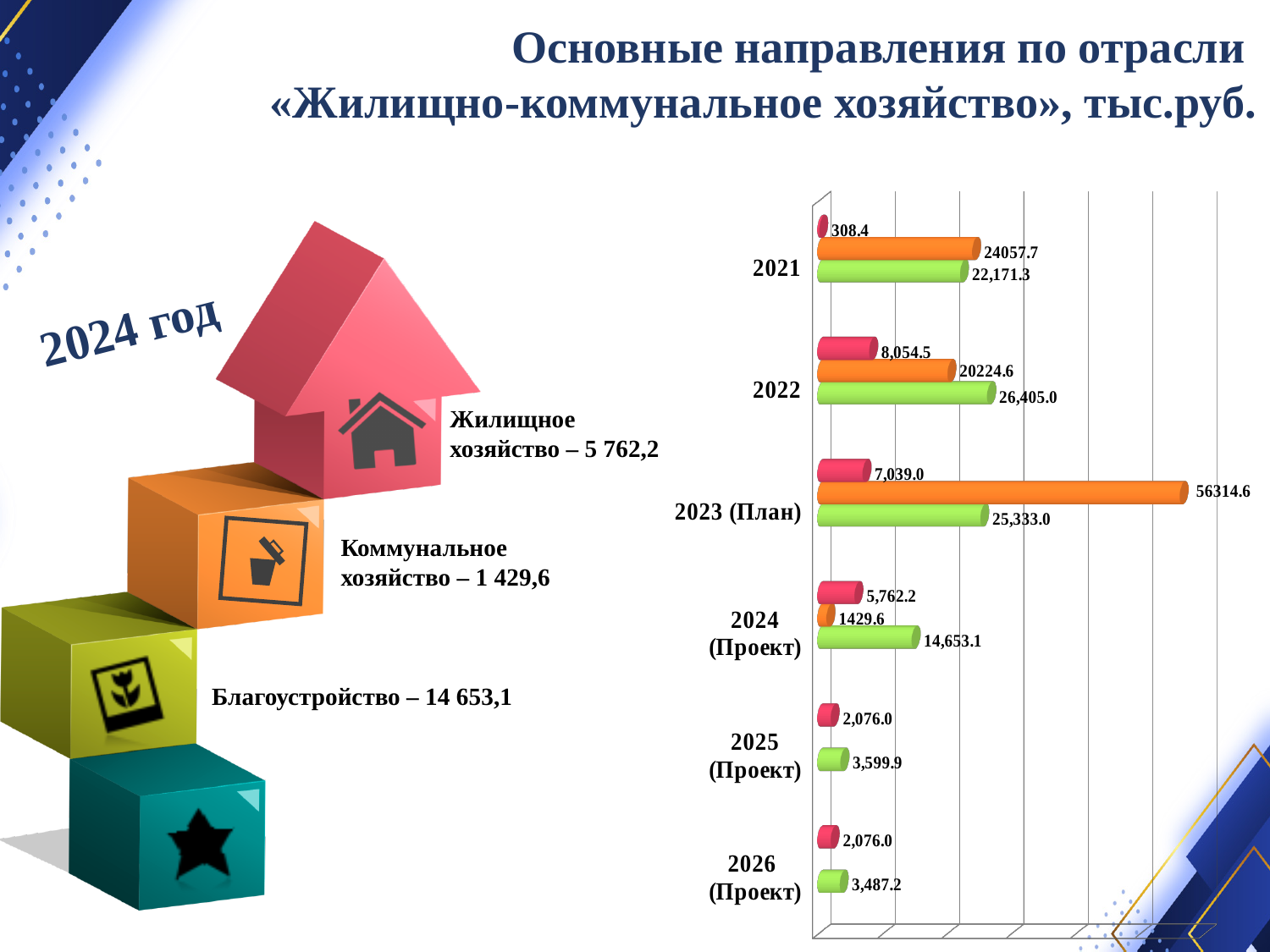
What is the difference between the green bar and the red bar for 2024 (Проект)? 8,890.9 What is the value of the green bar for 2026 (Проект)? 3,487.2 Which is larger for 2022: the green bar or the orange bar? the green bar What is the value of the red bar for 2021? 308.4 What kind of chart is shown on the slide? bar chart What is the value of the orange bar for 2023 (План)? 56314.6 How many year categories are shown on the chart? 6 Which year has the highest orange bar value? 2023 (План) Do the green bar values rise or fall from 2024 (Проект) to 2026 (Проект)? fall What is the value of the green bar for 2024 (Проект)? 14,653.1 Which year has the lowest red bar value? 2021 What unit is stated in the slide title for the chart values? тыс.руб.